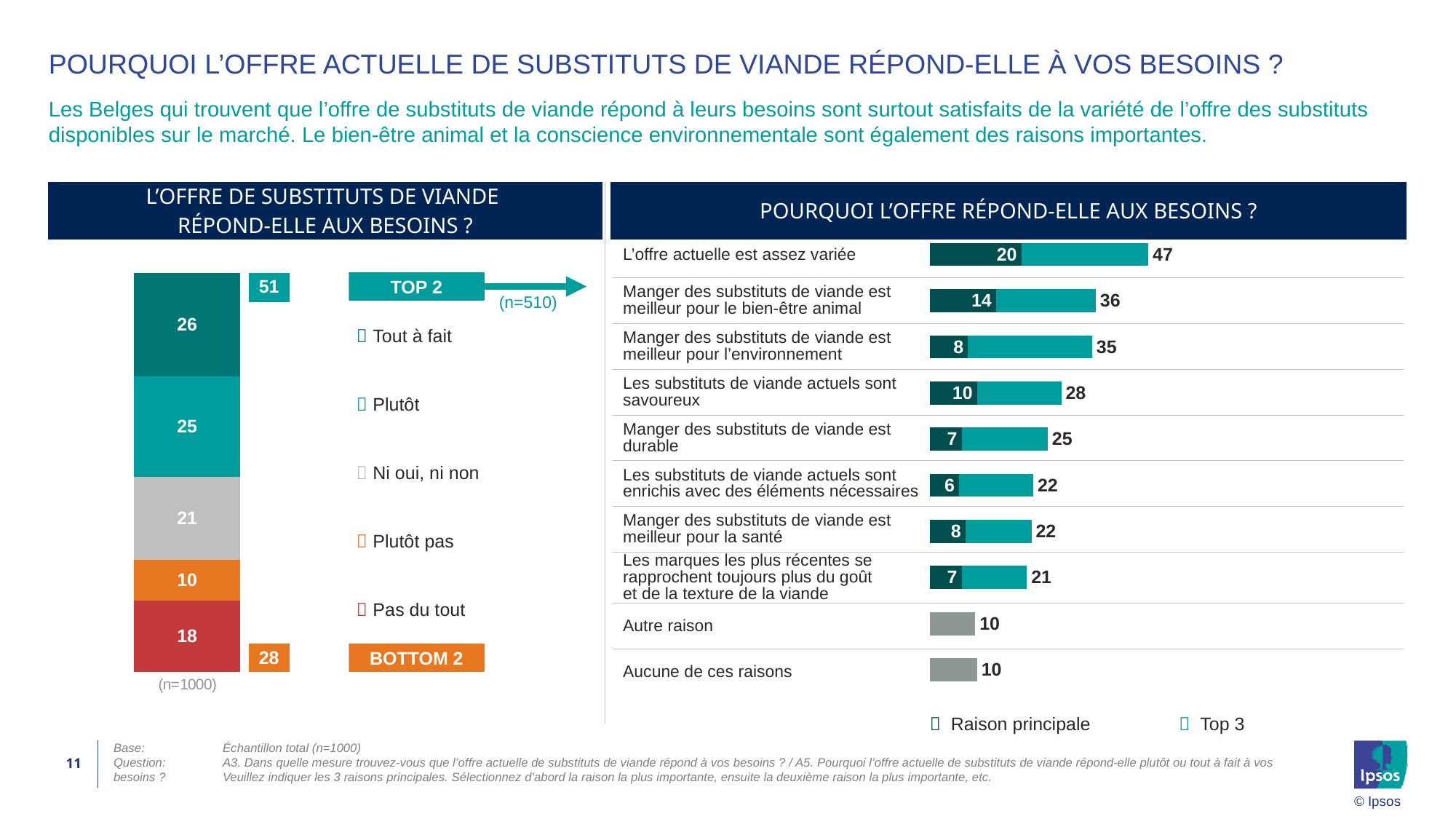
In the chart 'POURQUOI L'OFFRE RÉPOND-ELLE AUX BESOINS ?', what is the 'Raison principale' value for 'Manger des substituts de viande est meilleur pour le bien-être animal'? 14 In the chart 'L'OFFRE DE SUBSTITUTS DE VIANDE RÉPOND-ELLE AUX BESOINS ?', what is the value for 'Tout à fait'? 26 In the chart 'L'OFFRE DE SUBSTITUTS DE VIANDE RÉPOND-ELLE AUX BESOINS ?', what is the total of all segments in the stacked bar? 100 In the chart 'POURQUOI L'OFFRE RÉPOND-ELLE AUX BESOINS ?', what is the difference between the Top 3 values for 'L'offre actuelle est assez variée' and 'Manger des substituts de viande est meilleur pour le bien-être animal'? 11 What type of chart is 'POURQUOI L'OFFRE RÉPOND-ELLE AUX BESOINS ?'? Bar chart In the chart 'L'OFFRE DE SUBSTITUTS DE VIANDE RÉPOND-ELLE AUX BESOINS ?', what is the TOP 2 value? 51 In the chart 'POURQUOI L'OFFRE RÉPOND-ELLE AUX BESOINS ?', which has the larger Top 3 value: 'Les substituts de viande actuels sont savoureux' or 'Manger des substituts de viande est durable'? Les substituts de viande actuels sont savoureux In the chart 'POURQUOI L'OFFRE RÉPOND-ELLE AUX BESOINS ?', what is the Top 3 value for 'L'offre actuelle est assez variée'? 47 In the chart 'POURQUOI L'OFFRE RÉPOND-ELLE AUX BESOINS ?', how many series does the legend list? 2 In the chart 'POURQUOI L'OFFRE RÉPOND-ELLE AUX BESOINS ?', which reason has the highest Top 3 value? L'offre actuelle est assez variée In the chart 'POURQUOI L'OFFRE RÉPOND-ELLE AUX BESOINS ?', how many reasons are listed? 10 In the chart 'L'OFFRE DE SUBSTITUTS DE VIANDE RÉPOND-ELLE AUX BESOINS ?', which response category has the lowest value? Plutôt pas